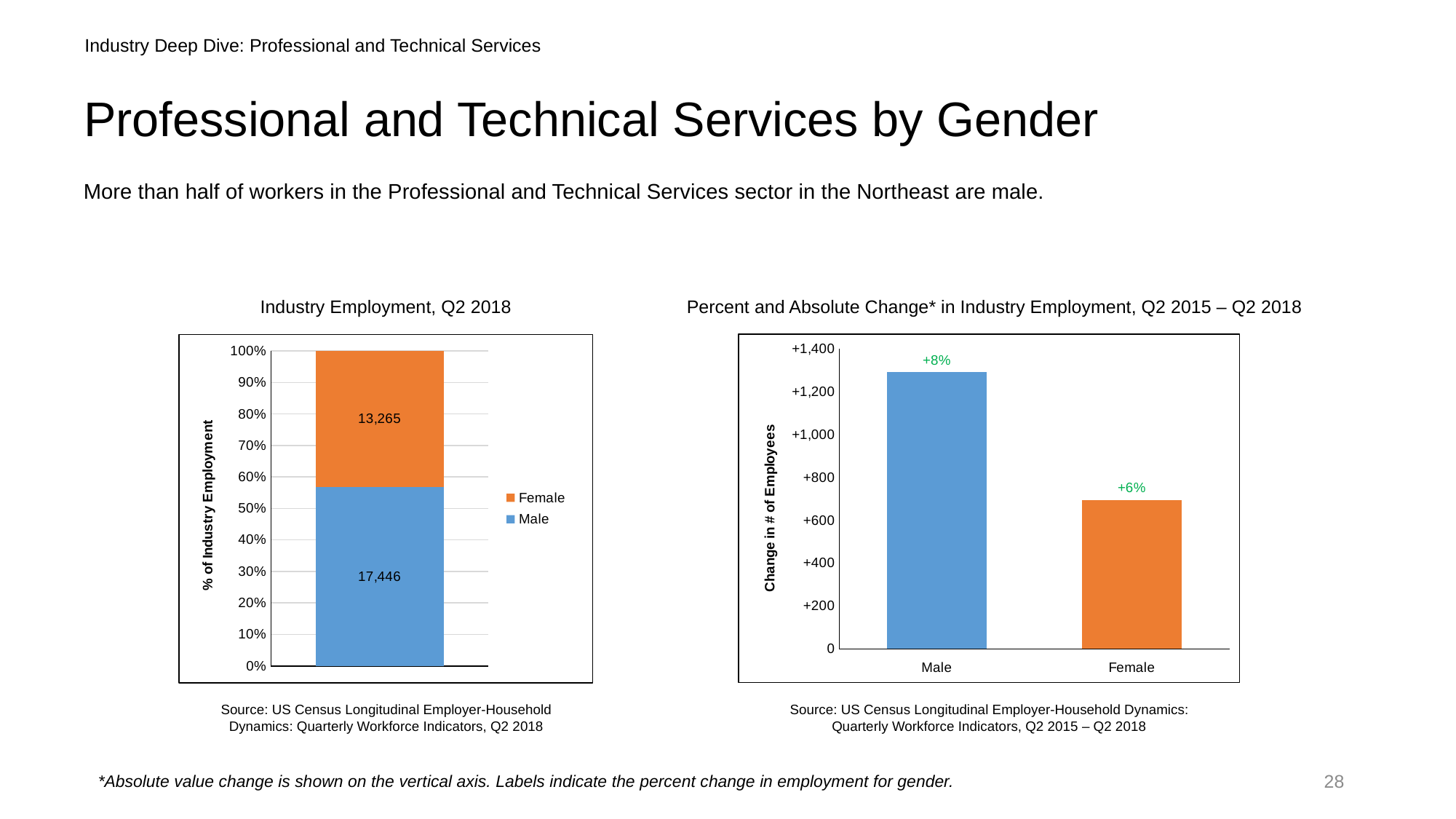
In the 'Percent and Absolute Change in Industry Employment, Q2 2015 – Q2 2018' chart, is the bar for Male greater or less than +1,200? greater In the 'Percent and Absolute Change in Industry Employment, Q2 2015 – Q2 2018' chart, which category has the highest bar? Male In the 'Industry Employment, Q2 2018' chart, what is the label of the vertical axis? % of Industry Employment In the 'Industry Employment, Q2 2018' chart, what is the total of the stacked bar? 30,711 In the 'Industry Employment, Q2 2018' chart, what is the value shown for Male? 17,446 In the 'Industry Employment, Q2 2018' chart, what is the value shown for Female? 13,265 In the 'Percent and Absolute Change in Industry Employment, Q2 2015 – Q2 2018' chart, what percent change label is shown for Male? +8% In the 'Industry Employment, Q2 2018' chart, what is the difference between the Male and Female values? 4,181 In the 'Industry Employment, Q2 2018' chart, which segment is larger, Male or Female? Male In the 'Percent and Absolute Change in Industry Employment, Q2 2015 – Q2 2018' chart, is the bar for Female greater or less than +800? less In the 'Percent and Absolute Change in Industry Employment, Q2 2015 – Q2 2018' chart, what percent change label is shown for Female? +6% In the 'Industry Employment, Q2 2018' chart, how many series does the legend list? 2